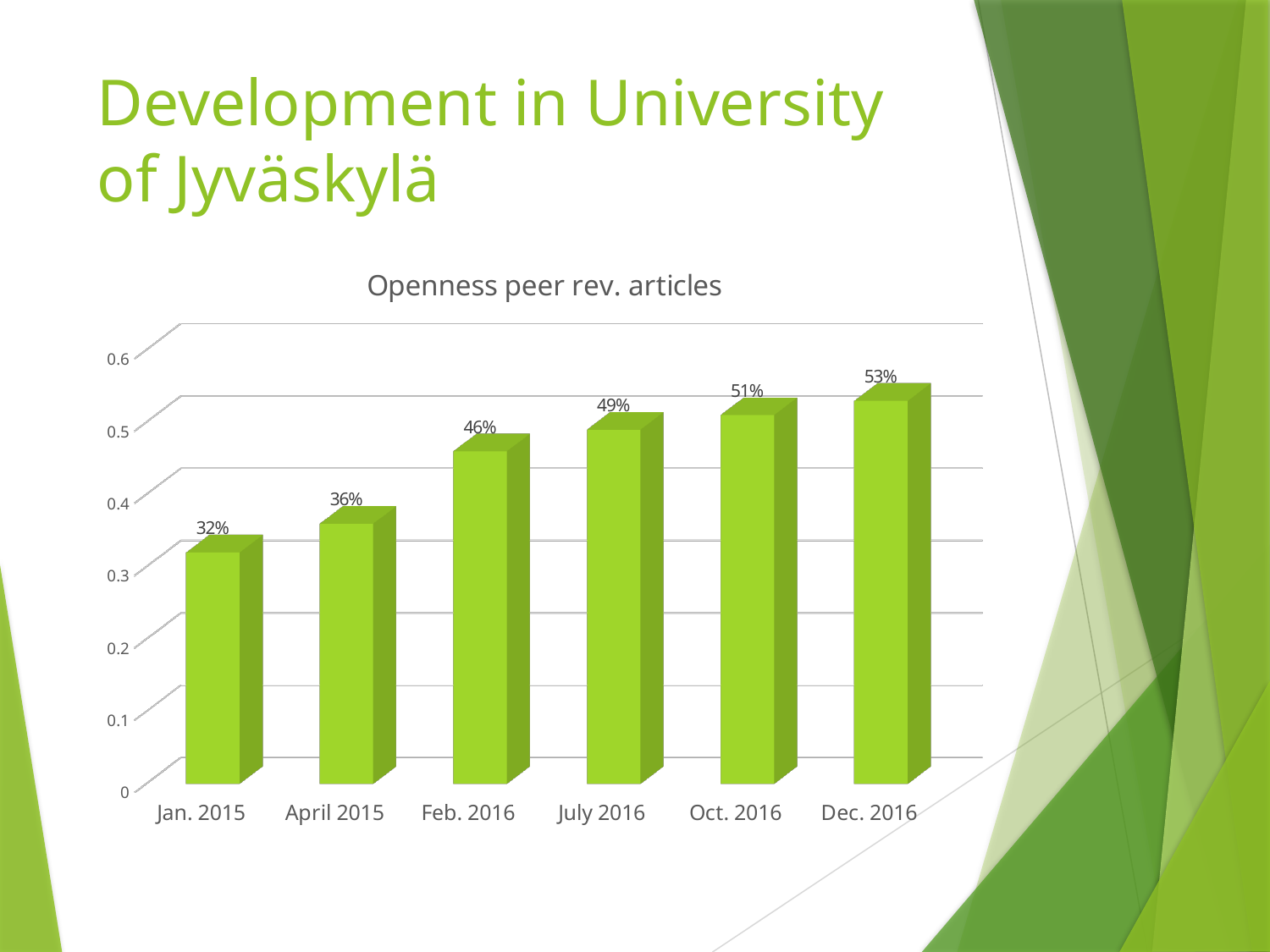
Which period has the highest value? Dec. 2016 Which period has the lowest value? Jan. 2015 What is the difference between the values for Dec. 2016 and Jan. 2015? 21% What is the value for Feb. 2016? 46% How many periods are shown on the x axis? 6 What kind of chart is shown? bar chart What is the value for Oct. 2016? 51% What is the value for Jan. 2015? 32% What is the difference between the values for Feb. 2016 and April 2015? 10% Which is larger, the value for July 2016 or the value for April 2015? July 2016 Do the values rise or fall from Jan. 2015 to Dec. 2016? rise What is the title of the chart? Openness peer rev. articles